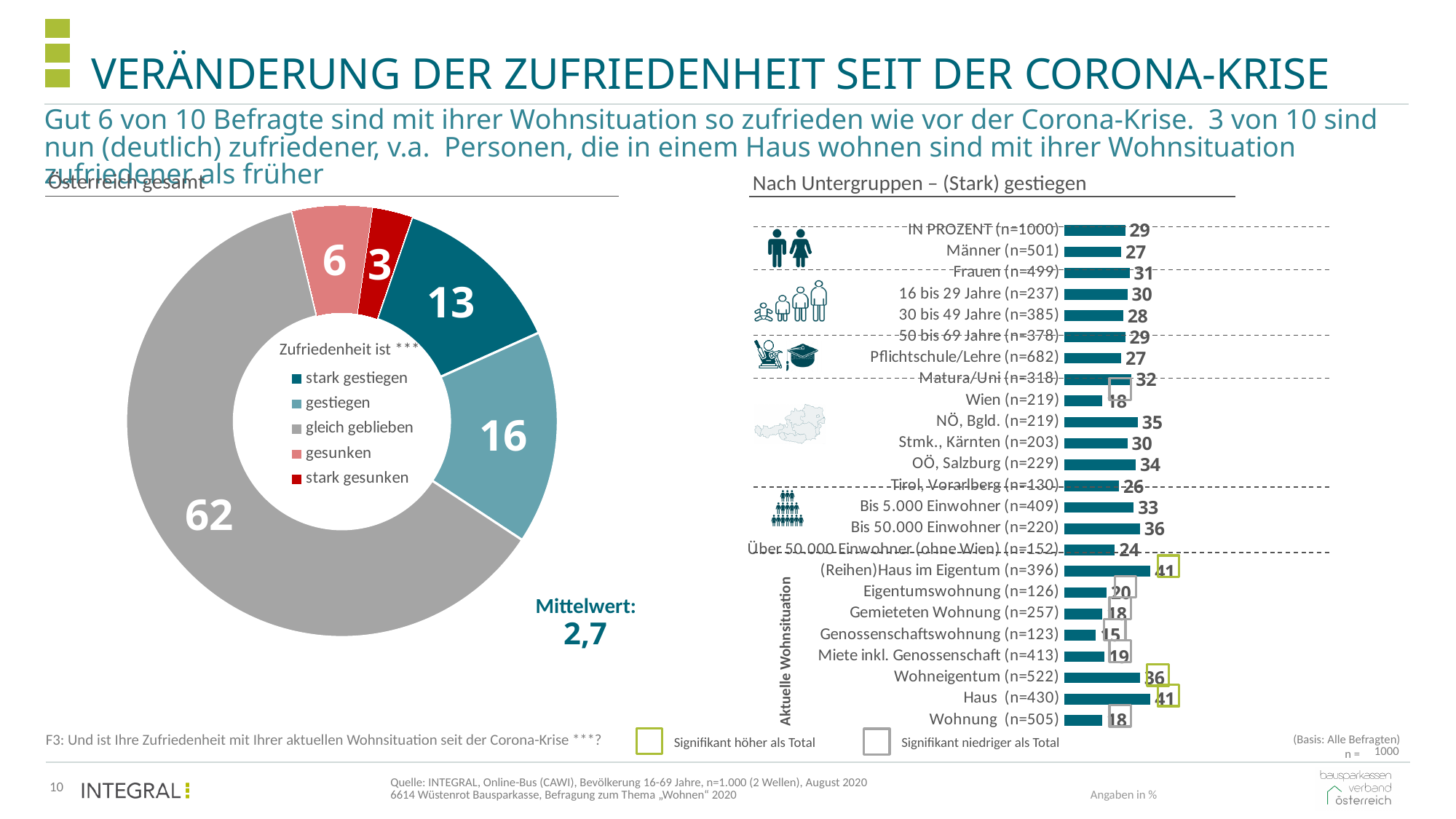
In the donut chart 'Österreich gesamt', what is the value for 'stark gestiegen'? 13 In the donut chart 'Österreich gesamt', what is the Mittelwert shown next to the chart? 2,7 In the bar chart 'Nach Untergruppen – (Stark) gestiegen', what is the value for 'Bis 50.000 Einwohner (n=220)'? 36 In the donut chart 'Österreich gesamt', what is the difference between 'gestiegen' and 'gesunken'? 10 In the bar chart 'Nach Untergruppen – (Stark) gestiegen', which is larger: 'Männer (n=501)' or 'Frauen (n=499)'? Frauen (n=499) In the bar chart 'Nach Untergruppen – (Stark) gestiegen', which category has the lowest value? Genossenschaftswohnung (n=123) In the donut chart 'Österreich gesamt', how many categories does the legend list? 5 In the donut chart 'Österreich gesamt', what is the value for 'gleich geblieben'? 62 In the bar chart 'Nach Untergruppen – (Stark) gestiegen', what is the value for 'Wien (n=219)'? 18 What type of chart is 'Nach Untergruppen – (Stark) gestiegen'? bar chart In the bar chart 'Nach Untergruppen – (Stark) gestiegen', what is the difference between 'Haus (n=430)' and 'Wohnung (n=505)'? 23 In the donut chart 'Österreich gesamt', which category has the smallest share? stark gesunken